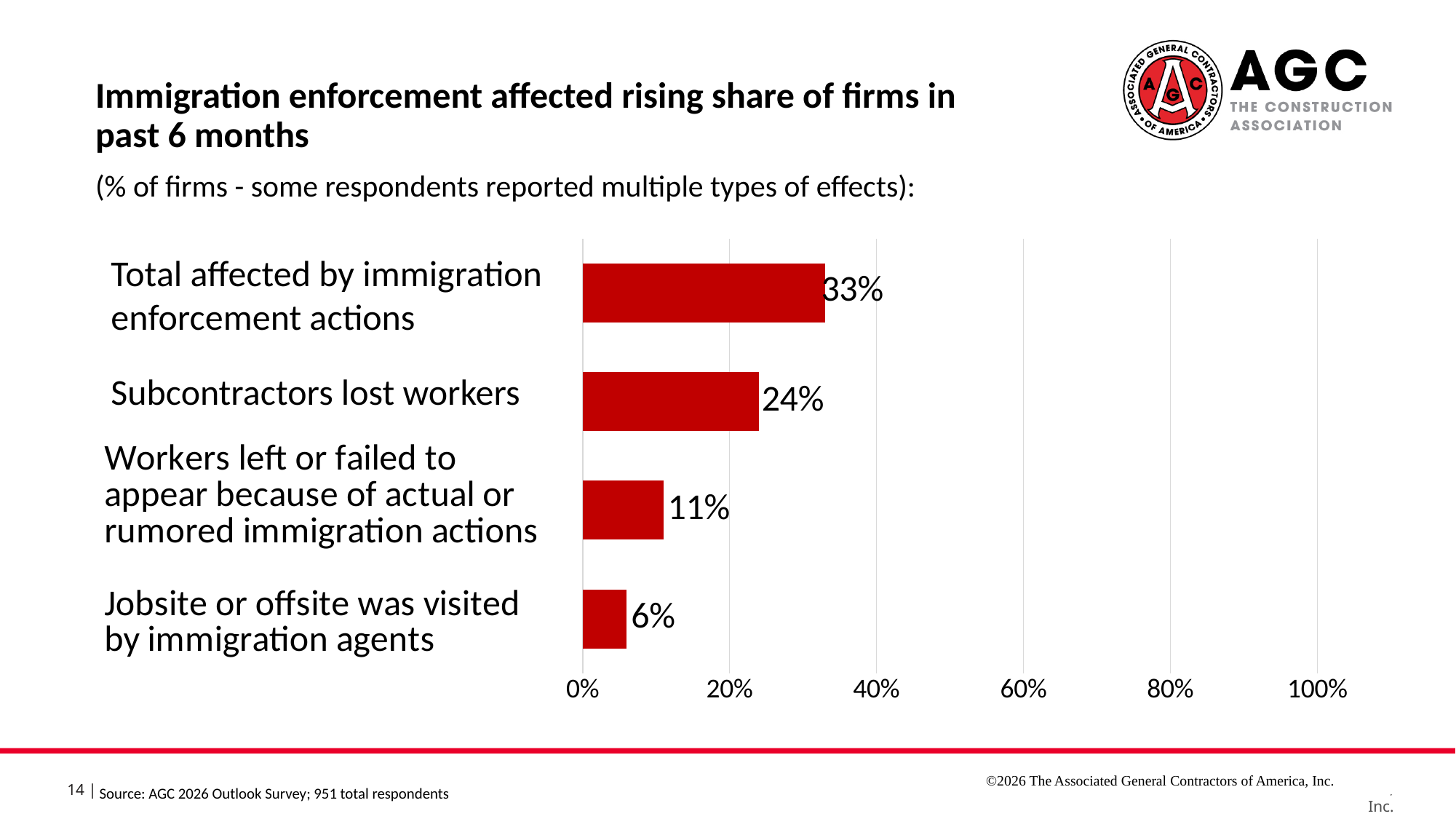
What is the value for 'Total affected by immigration enforcement actions'? 33% Which is larger: 'Subcontractors lost workers' or 'Jobsite or offsite was visited by immigration agents'? Subcontractors lost workers What is the value for 'Jobsite or offsite was visited by immigration agents'? 6% Is the value for 'Total affected by immigration enforcement actions' greater or less than 40%? less What is the difference between 'Subcontractors lost workers' and 'Workers left or failed to appear because of actual or rumored immigration actions'? 13% What share of firms reported workers left or failed to appear because of actual or rumored immigration actions? 11% What percentage of firms reported that subcontractors lost workers? 24% What kind of chart is shown on the slide? Bar chart What is the maximum value shown on the x axis? 100% How many categories are shown in the chart? 4 Which category has the lowest value? Jobsite or offsite was visited by immigration agents Which category has the highest value? Total affected by immigration enforcement actions